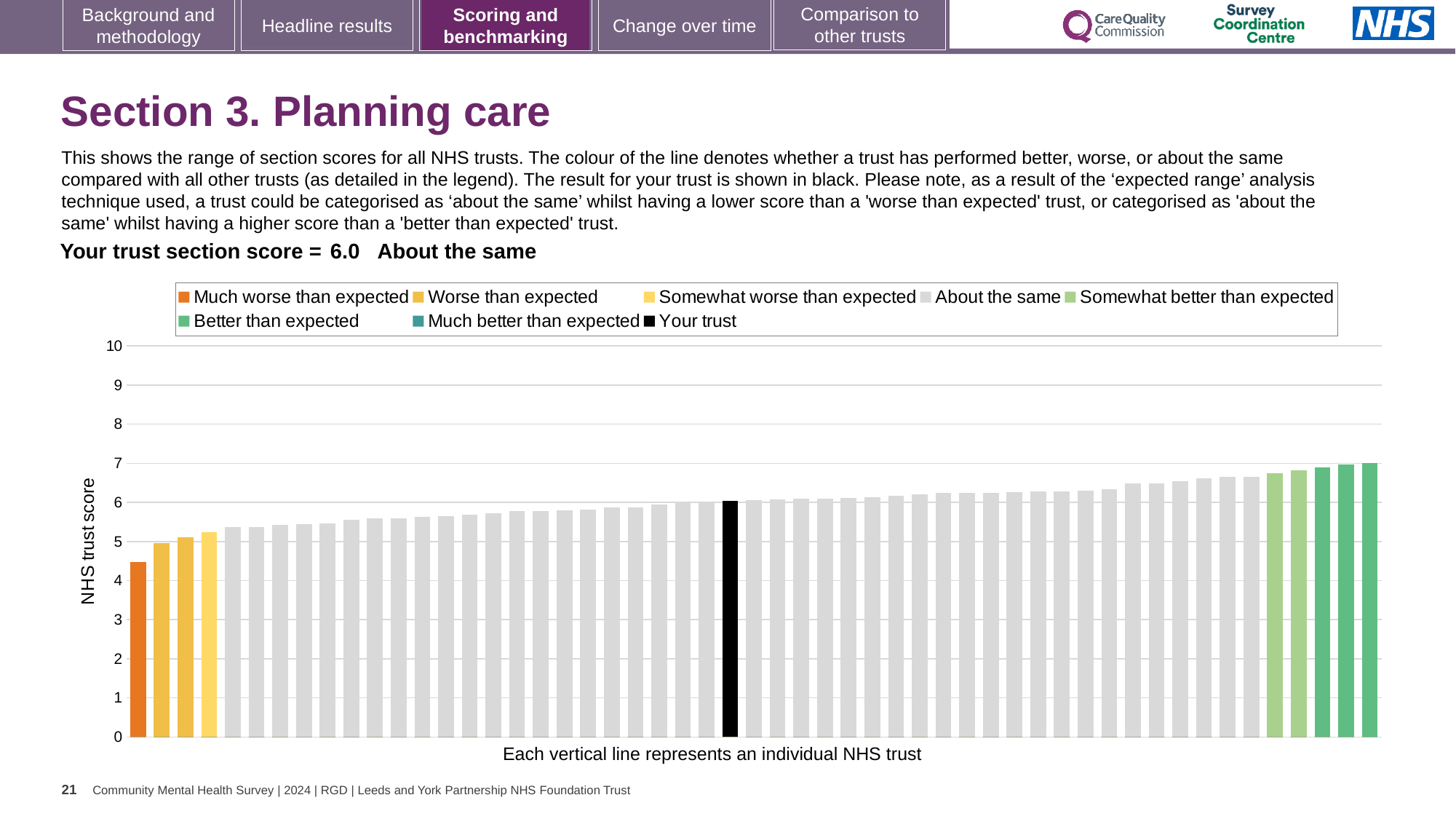
Which legend category does the lowest-scoring trust belong to? Much worse than expected Which performance category is your trust placed in for Section 3. Planning care? About the same How many trusts are shown as 'Better than expected'? 3 What kind of chart is used to show the range of section scores? Bar chart Is the score of the highest-scoring trust greater or less than 6? greater What is the label on the vertical axis of the chart? NHS trust score Do the trust scores rise or fall moving from left to right along the x axis? rise Is the score of the lowest-scoring trust (the orange bar) greater or less than 5? less What is the section score for your trust shown on the slide? 6.0 How many trusts are shown as 'Much worse than expected'? 1 Which legend category does the highest-scoring trust belong to? Better than expected How many entries does the chart legend list? 8